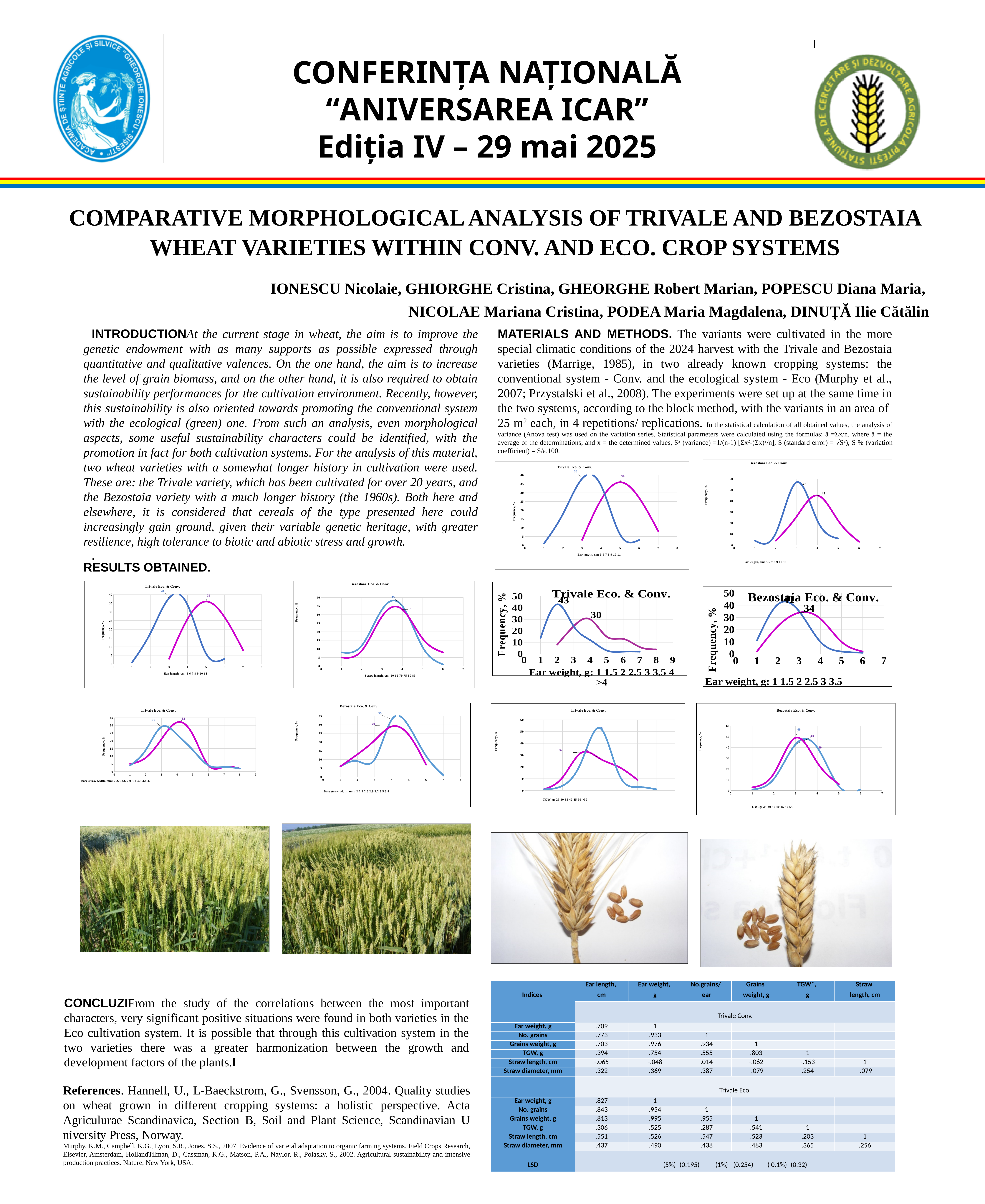
In the large 'Trivale Eco. & Conv.' ear weight chart, what is the difference between the two labelled peak values, 43 and 30? 13 In the large 'Trivale Eco. & Conv.' ear weight chart, which line has the higher labelled peak, the blue or the magenta one? blue In the 'Bezostaia Eco. & Conv.' ear length chart at the top right of the poster, what is the peak value labelled on the blue line? 57 How many lines are plotted in the large 'Trivale Eco. & Conv.' ear weight chart? 2 In the large 'Bezostaia Eco. & Conv.' ear weight chart, what are the two labelled peak values? 41 and 34 What kind of chart is the large 'Trivale Eco. & Conv.' ear weight chart in the middle right of the poster? line chart In the large 'Trivale Eco. & Conv.' ear weight chart, what is the peak value labelled on the blue line? 43 In the large 'Bezostaia Eco. & Conv.' ear weight chart, what is the difference between the labelled peaks 44 and 34? 7 In the large 'Bezostaia Eco. & Conv.' ear weight chart, is the value of the blue line at x = 6 greater or less than 10? less In the large 'Trivale Eco. & Conv.' ear weight chart, what is the peak value labelled on the magenta line? 30 What is the highest value shown on the y axis of the large 'Trivale Eco. & Conv.' ear weight chart? 50 In the 'Bezostaia Eco. & Conv.' ear length chart at the top right of the poster, what is the difference between the labelled peaks 57 and 45? 12